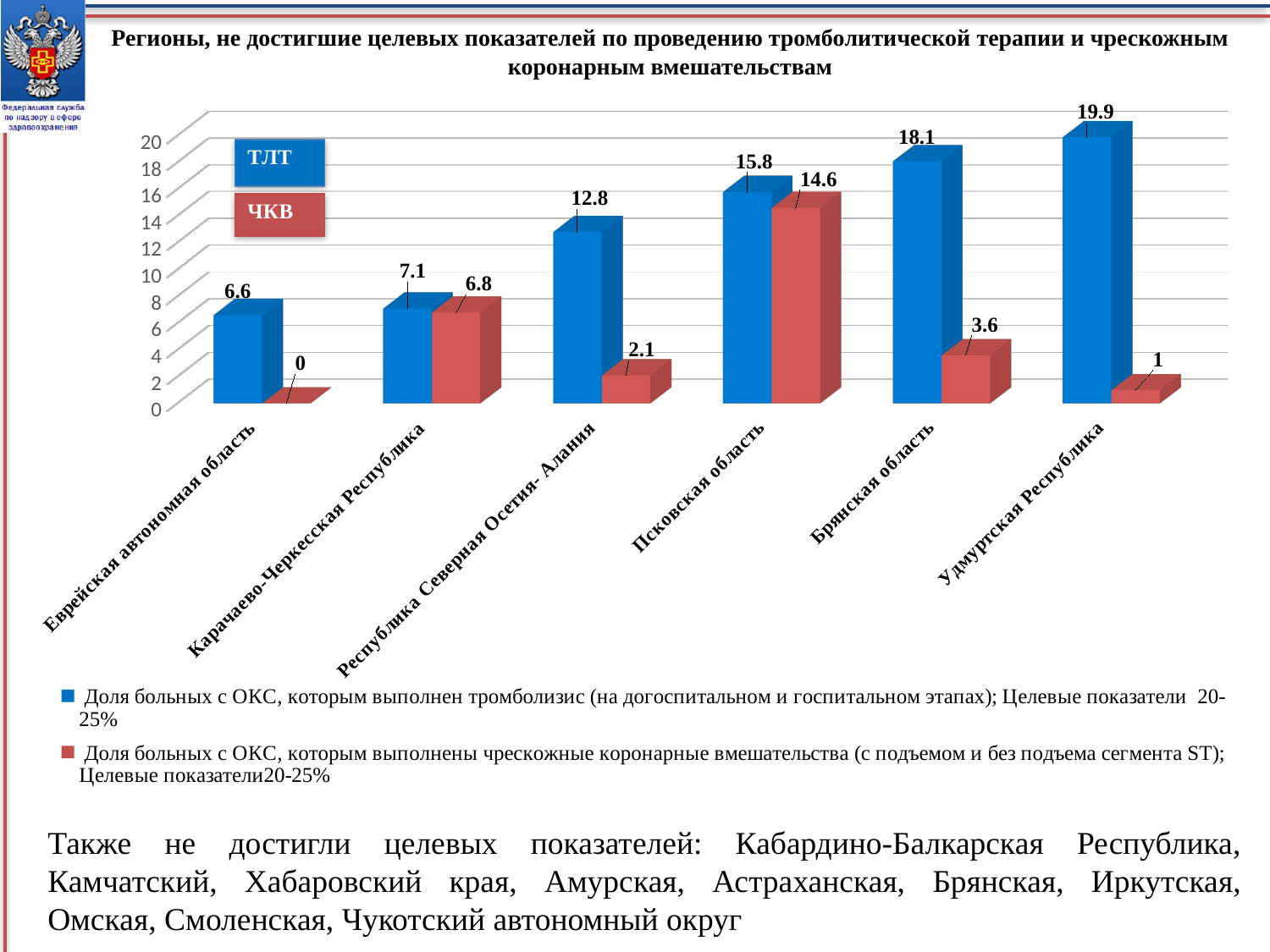
What is the ЧКВ value for Еврейская автономная область? 0 How many series does the chart show? 2 What type of chart is shown on the slide? Bar chart Is the ТЛТ value for Брянская область greater or less than 16? greater Do the ТЛТ values rise or fall from left to right across the regions? Rise Which is larger for Карачаево-Черкесская Республика, the ТЛТ value or the ЧКВ value? ТЛТ What is the ЧКВ value for Брянская область? 3.6 What is the ТЛТ value for Псковская область? 15.8 Which region has the lowest ЧКВ value? Еврейская автономная область How many regions are shown on the chart? 6 Which region has the highest ТЛТ value? Удмуртская Республика What is the difference between the ТЛТ and ЧКВ values for Республика Северная Осетия-Алания? 10.7